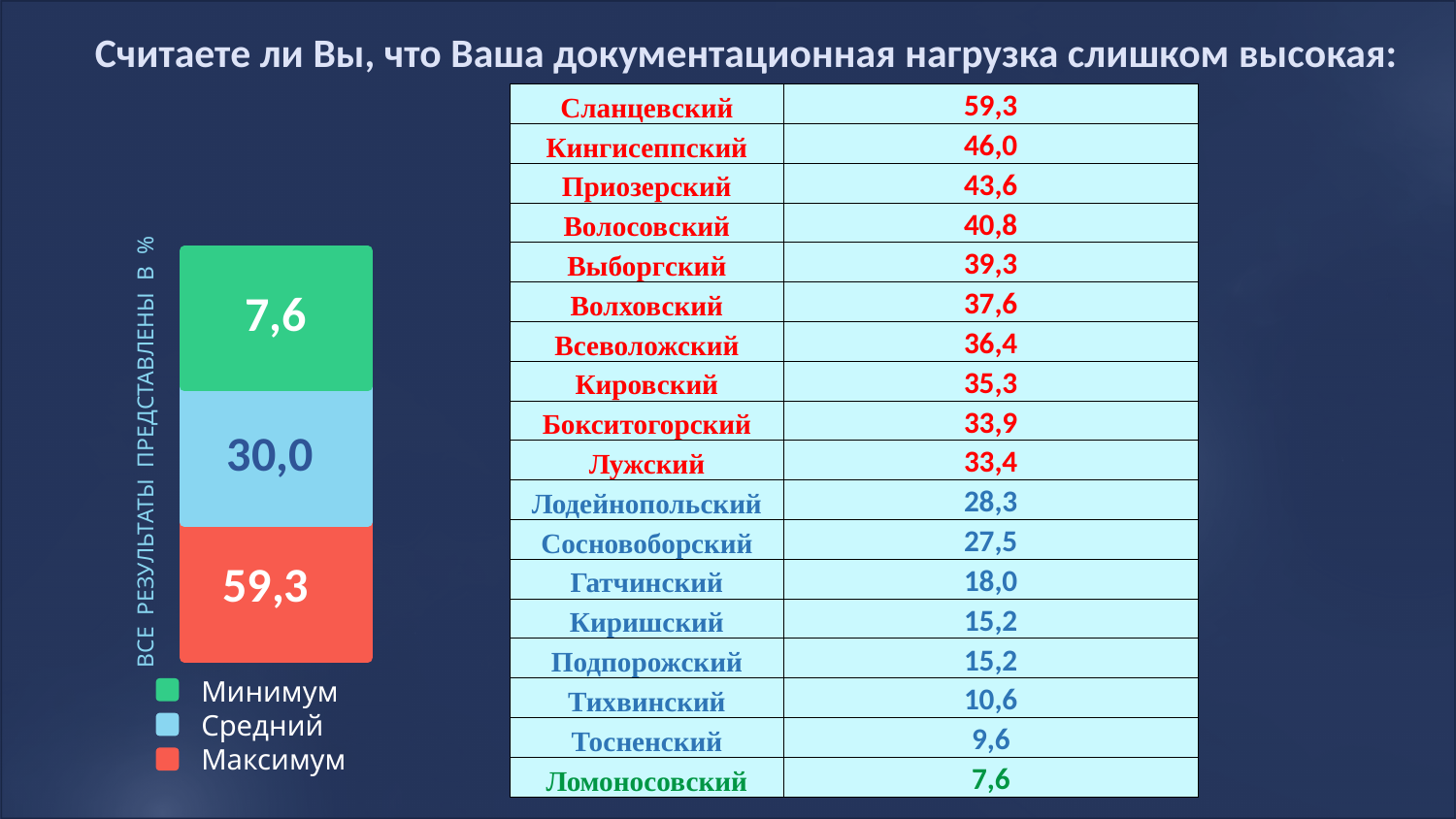
What is the difference between the Максимум and Средний values in the stacked bar? 29,3 Which segment of the stacked bar has the smallest value? Минимум What is the total of all segments in the stacked bar? 96,9 Which is larger in the stacked bar, Средний or Минимум? Средний What kind of chart is shown on the left of the slide? Stacked bar chart What is the value of the Средний segment in the stacked bar? 30,0 What is the difference between the Максимум and Минимум values in the stacked bar? 51,7 What is the value of the Минимум segment in the stacked bar? 7,6 How many entries does the chart legend list? 3 Which segment of the stacked bar has the largest value? Максимум What is the value of the Максимум segment in the stacked bar? 59,3 What colour is the Максимум segment in the stacked bar? Red